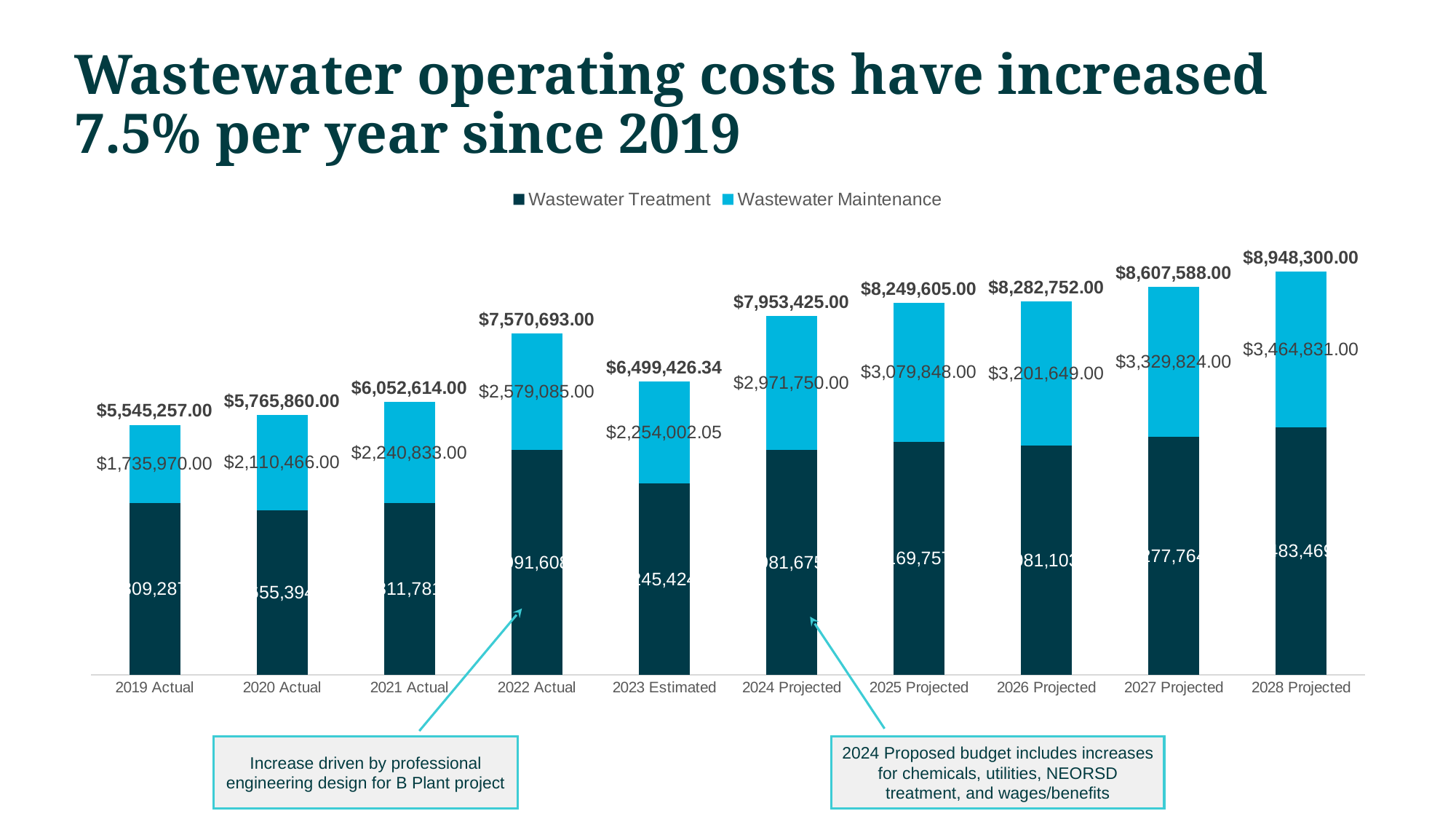
What is the difference between the total for 2028 Projected and the total for 2019 Actual? $3,403,043.00 Which has the larger total wastewater operating cost, 2022 Actual or 2023 Estimated? 2022 Actual What is the total wastewater operating cost shown for 2019 Actual? $5,545,257.00 What is the total wastewater operating cost shown for 2028 Projected? $8,948,300.00 Which year has the highest total wastewater operating cost? 2028 Projected Which year has the lowest total wastewater operating cost? 2019 Actual What is the Wastewater Maintenance value for 2023 Estimated? $2,254,002.05 How many years (categories) are shown on the x axis of the chart? 10 How many series does the legend list? 2 What is the Wastewater Maintenance value for 2024 Projected? $2,971,750.00 Which series is shown in the darker colour at the bottom of each bar? Wastewater Treatment What kind of chart is shown on the slide? Stacked bar chart